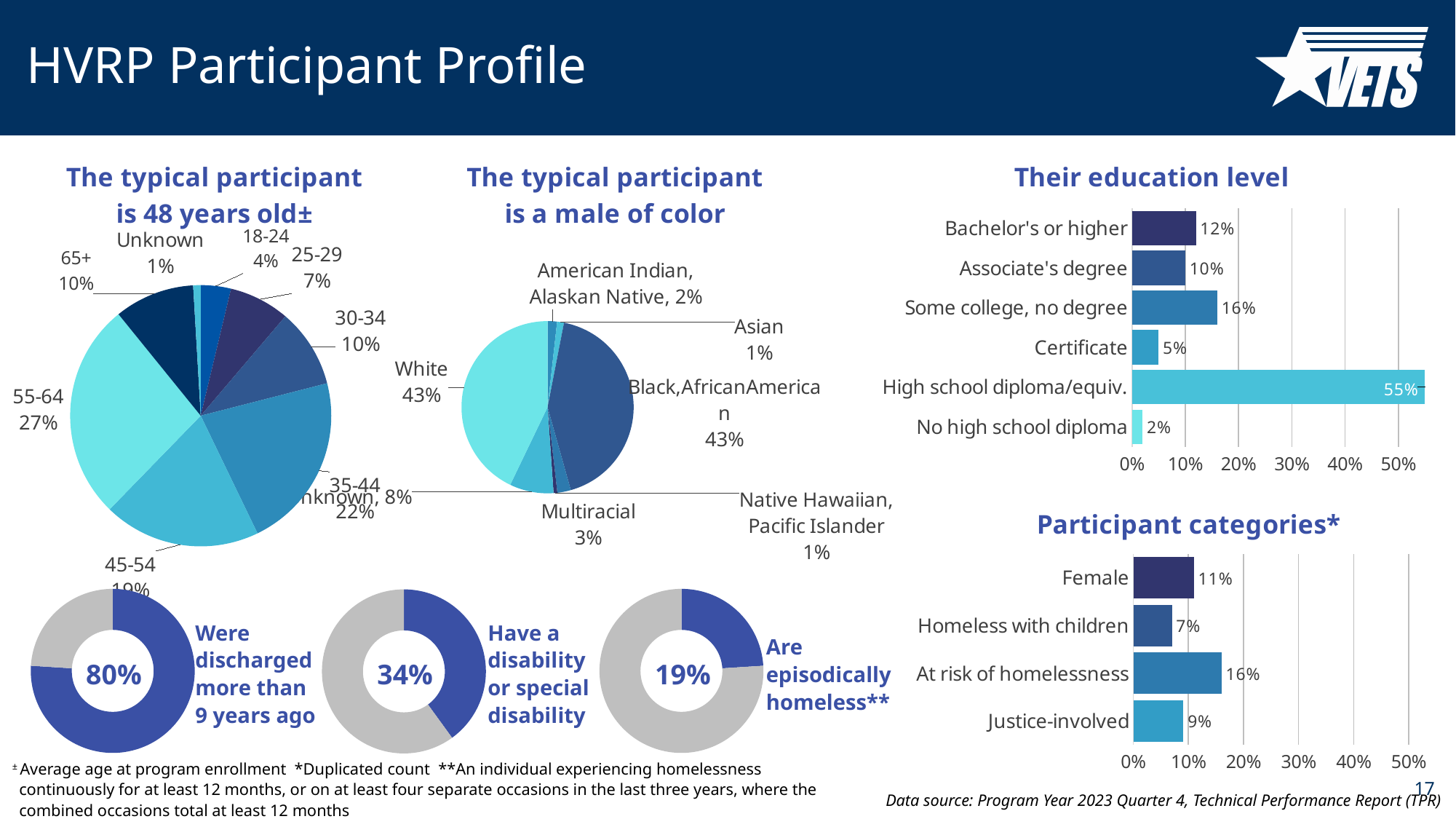
What type of chart is "Participant categories*"? Bar chart In the "Participant categories*" chart, which category has the highest percentage? At risk of homelessness In the "Participant categories*" chart, what percentage of participants are Justice-involved? 9% In the "Their education level" chart, which education level has the lowest percentage? No high school diploma In the "Participant categories*" chart, which is larger: Female or Homeless with children? Female In the "Their education level" chart, what is the difference between Some college, no degree and Associate's degree? 6% In the donut chart labelled "Have a disability or special disability", what percentage is shown? 34% In the age pie chart "The typical participant is 48 years old±", what share of participants are aged 55-64? 27% In the "Their education level" chart, what percentage of participants have a high school diploma/equiv.? 55% In the age pie chart "The typical participant is 48 years old±", which age group has the largest share? 55-64 In the "Their education level" chart, how many education categories are shown? 6 In the race pie chart "The typical participant is a male of color", what share of participants are White? 43%